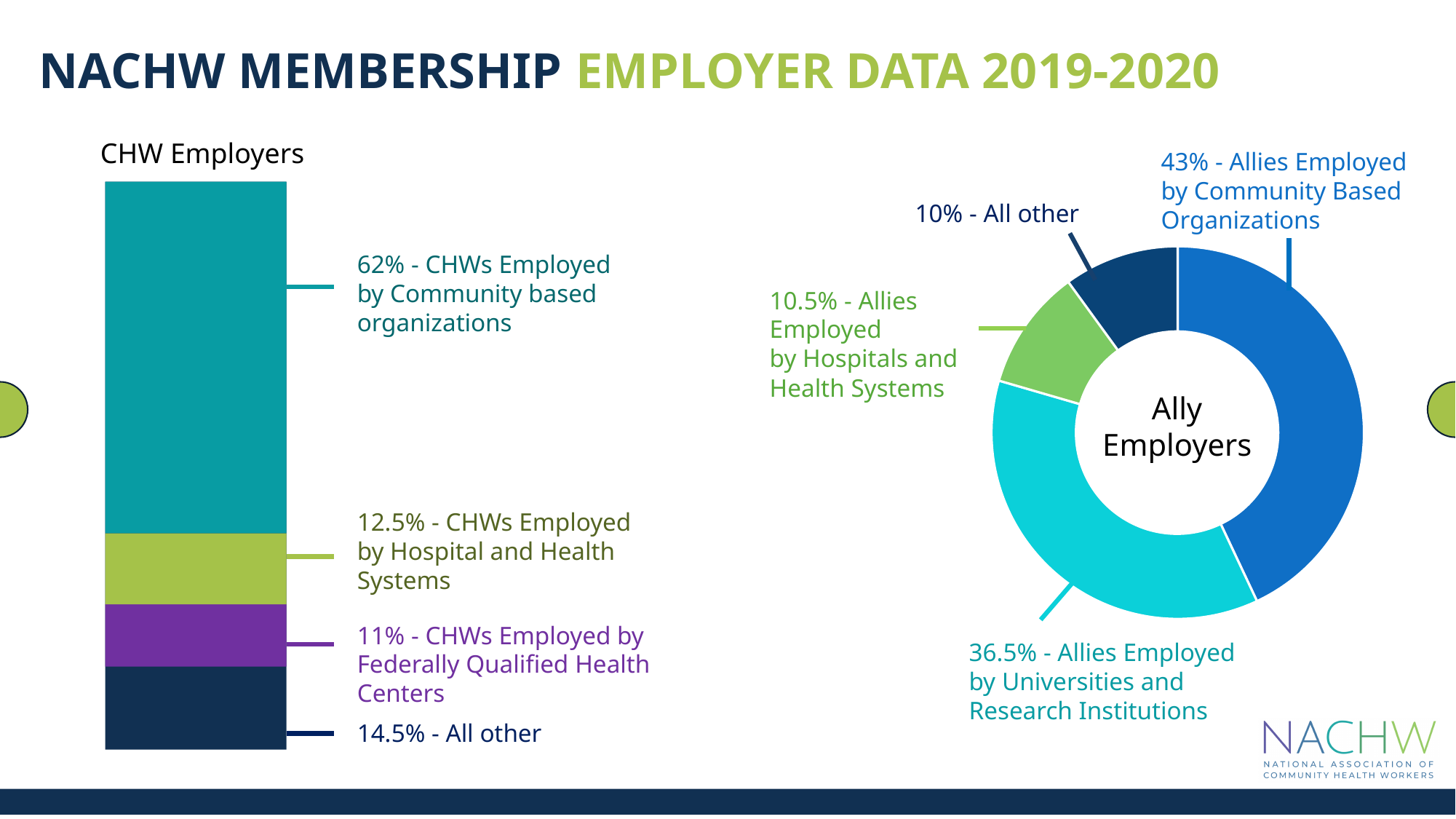
In the CHW Employers chart, which is larger: the share for All other or the share for Federally Qualified Health Centers? All other What type of chart is the CHW Employers chart? Stacked bar chart In the Ally Employers chart, what share of allies are employed by Hospitals and Health Systems? 10.5% In the CHW Employers chart, what percentage of CHWs are employed by Federally Qualified Health Centers? 11% In the CHW Employers chart, which employer category has the largest share? Community based organizations In the CHW Employers chart, what percentage of CHWs are employed by community based organizations? 62% In the Ally Employers chart, what is the difference between the Community Based Organizations share and the Universities and Research Institutions share? 6.5% In the Ally Employers chart, which category has the smallest share? All other In the Ally Employers chart, what share of allies are employed by Universities and Research Institutions? 36.5% What type of chart is the Ally Employers chart? Donut chart In the CHW Employers chart, what is the difference between the share employed by community based organizations and the share employed by Hospital and Health Systems? 49.5% How many segments does the Ally Employers donut chart have? 4